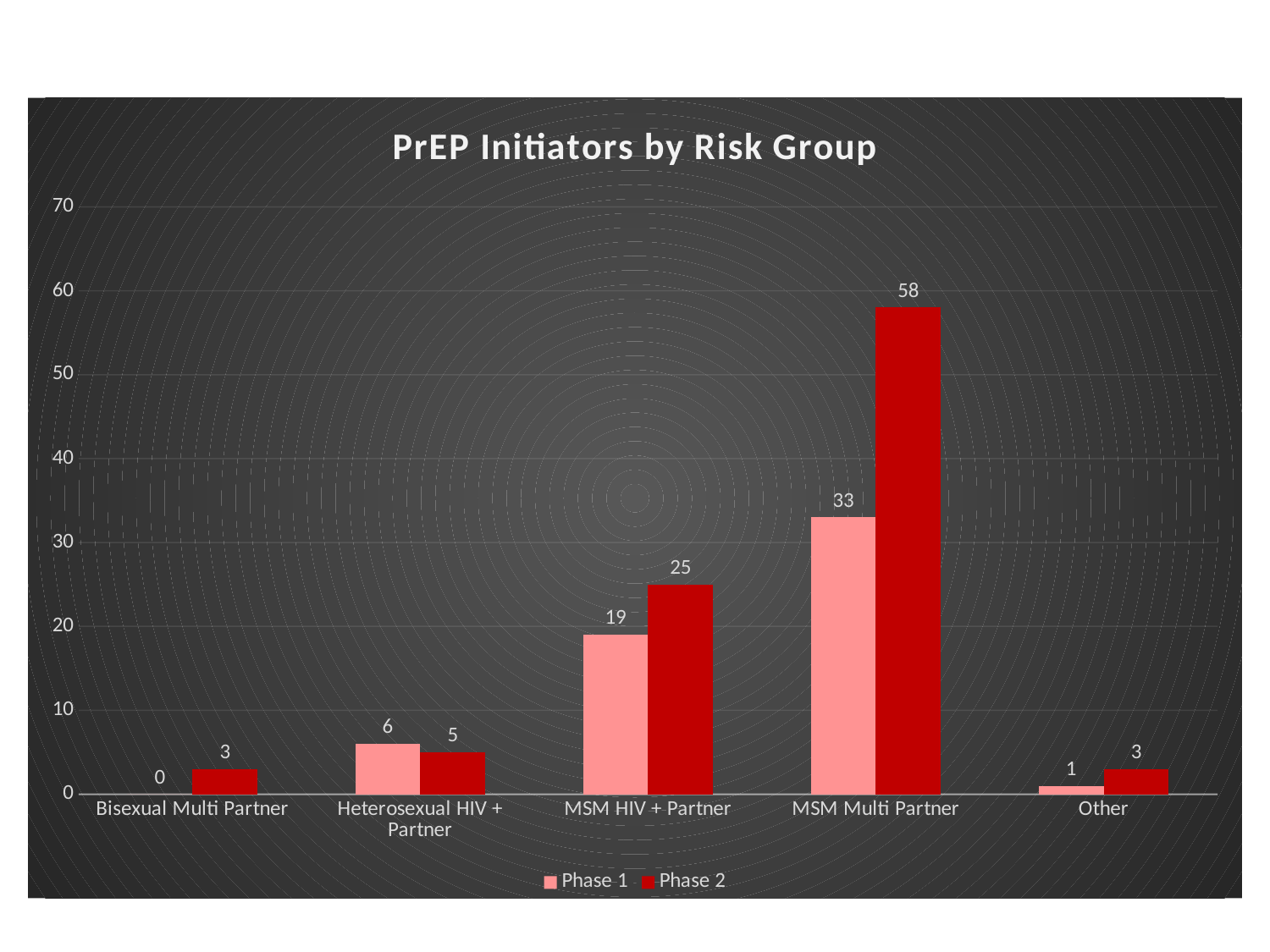
What kind of chart is shown on the slide? Bar chart How many risk group categories are shown on the x axis? 5 Which risk group has the highest Phase 2 value? MSM Multi Partner Which risk group has the lowest Phase 1 value? Bisexual Multi Partner How many series does the legend list? 2 What is the Phase 2 value for MSM Multi Partner? 58 What is the Phase 1 value for MSM HIV + Partner? 19 What is the title of the chart? PrEP Initiators by Risk Group Which is larger for Heterosexual HIV + Partner, Phase 1 or Phase 2? Phase 1 What is the Phase 1 value for Bisexual Multi Partner? 0 What is the difference between the Phase 2 and Phase 1 values for MSM Multi Partner? 25 Is the Phase 2 value for MSM HIV + Partner greater or less than 20? greater